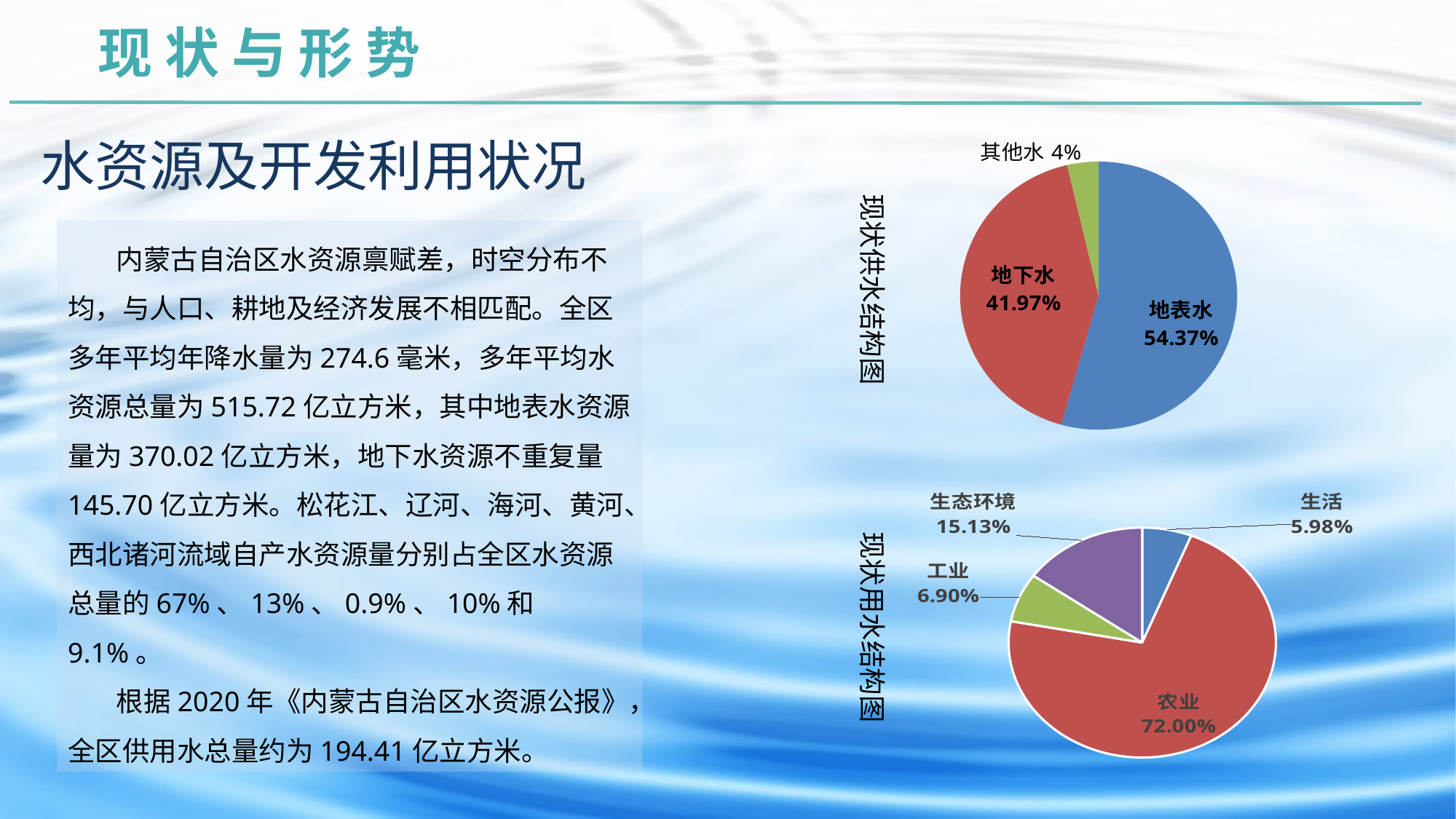
In the bottom chart titled 现状用水结构图, what share does 生态环境 have? 15.13% In the bottom chart titled 现状用水结构图, which is larger, 工业 or 生活? 工业 In the bottom chart titled 现状用水结构图, which category has the smallest share? 生活 In the bottom chart titled 现状用水结构图, what is the difference between the shares of 农业 and 生态环境? 56.87% What kind of chart is the bottom chart titled 现状用水结构图? Pie chart In the top chart titled 现状供水结构图, what share does 地下水 have? 41.97% In the top chart titled 现状供水结构图, which category has the smallest share? 其他水 In the top chart titled 现状供水结构图, what share does 地表水 have? 54.37% In the top chart titled 现状供水结构图, what share does 其他水 have? 4% In the top chart titled 现状供水结构图, which category has the largest share? 地表水 In the top chart titled 现状供水结构图, how many slices does the pie have? 3 In the bottom chart titled 现状用水结构图, what share does 农业 have? 72.00%